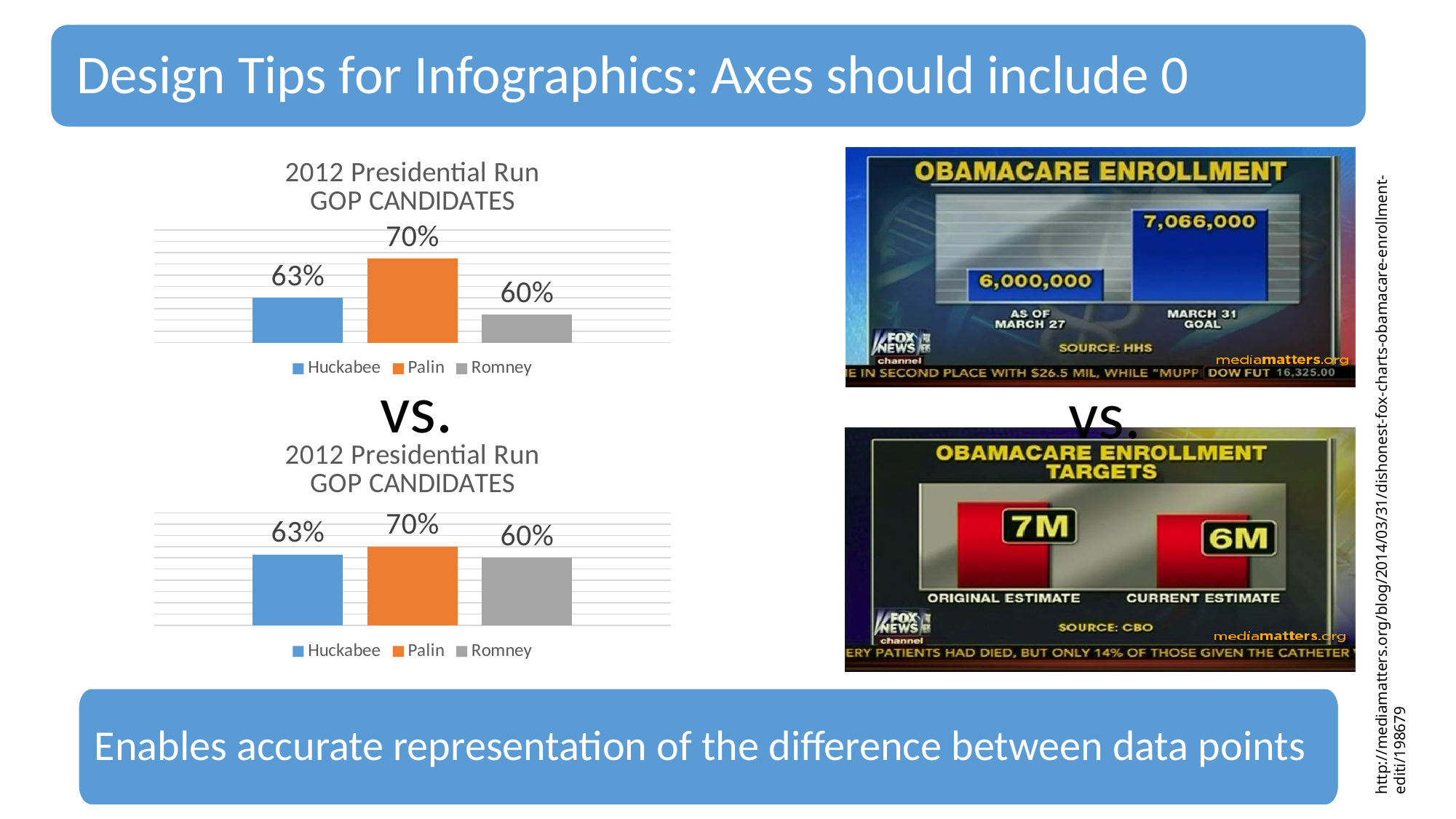
In the top-left chart, which candidate has the highest value? Palin In the bottom-left chart, which is larger, the value for Huckabee or the value for Romney? Huckabee What kind of chart is the top-left chart? Bar chart In the top-right 'Obamacare Enrollment' chart, what is the value for the March 31 goal? 7,066,000 How many series does the legend of the bottom-left chart list? 3 In the top-left chart, what is the value for Romney? 60% In the top-left chart, what is the difference between Palin's and Huckabee's values? 7% In the bottom-right 'Obamacare Enrollment Targets' chart, what is the current estimate? 6M In the bottom-left chart, which candidate has the lowest value? Romney In the top-left chart, what is the value for Palin? 70% What is the title of the bottom-left chart? 2012 Presidential Run GOP CANDIDATES In the bottom-left chart, what is the value for Huckabee? 63%